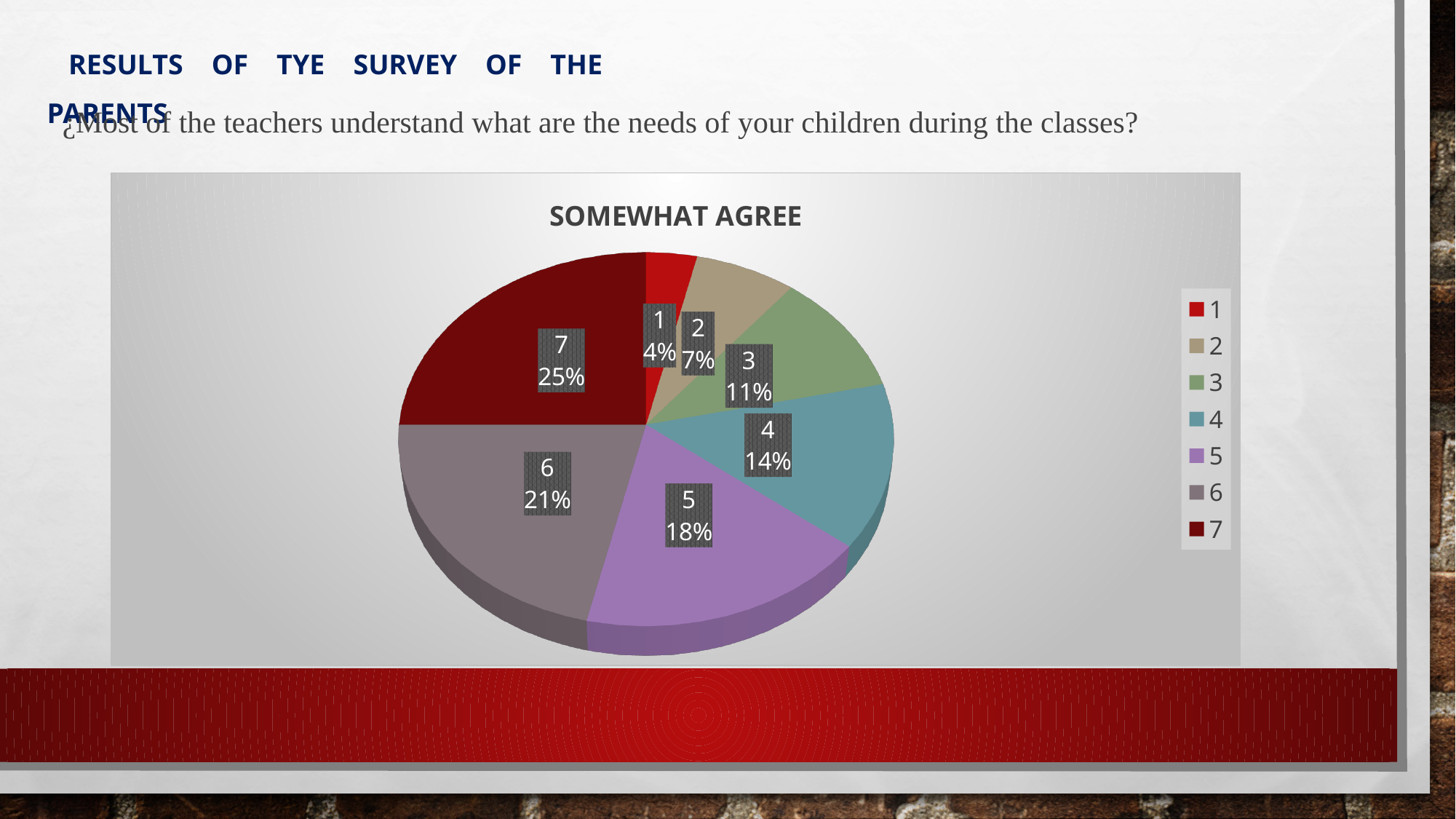
What is the title of the chart? SOMEWHAT AGREE Which category has the smallest share of the pie? 1 What is the value shown for category 5? 18% What is the value shown for category 2? 7% What share of the pie does category 7 represent? 25% How many entries does the legend list? 7 Which is larger, the share for category 5 or the share for category 4? 5 Which category has the largest share of the pie? 7 What kind of chart is shown on the slide? pie chart What is the difference between the shares of category 6 and category 3? 10% What share of the pie does category 4 represent? 14% How many slices does the pie chart have? 7